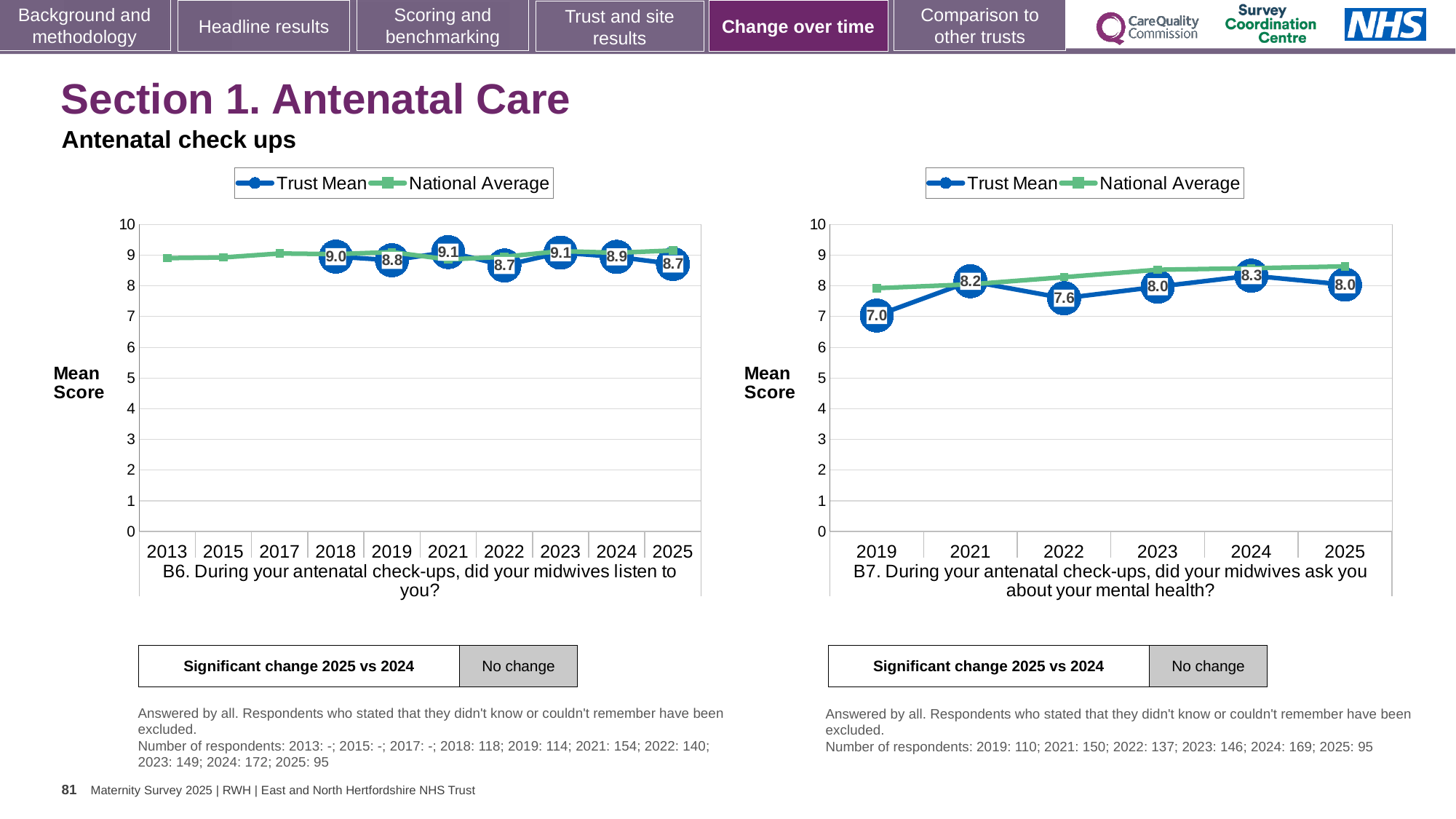
In the B7 chart on the right, which year has the highest Trust Mean score? 2024 In the B7 chart on the right, which year has the lowest Trust Mean score? 2019 How many series does the legend of the B6 chart on the left list? 2 In the B6 chart on the left, which is larger, the Trust Mean for 2023 or for 2022? 2023 In the B6 chart on the left, what is the Trust Mean score for 2018? 9.0 In the B7 chart on the right, what does the 'Significant change 2025 vs 2024' box say? No change In the B6 chart on the left, what is the Trust Mean score for 2025? 8.7 How many years are shown on the x axis of the B7 chart on the right? 6 What type of chart is the B7 chart on the right? Line chart In the B7 chart on the right, what is the Trust Mean score for 2019? 7.0 In the B7 chart on the right, what is the difference between the Trust Mean scores for 2021 and 2019? 1.2 In the B6 chart on the left, is the National Average for 2013 greater or less than 8? greater